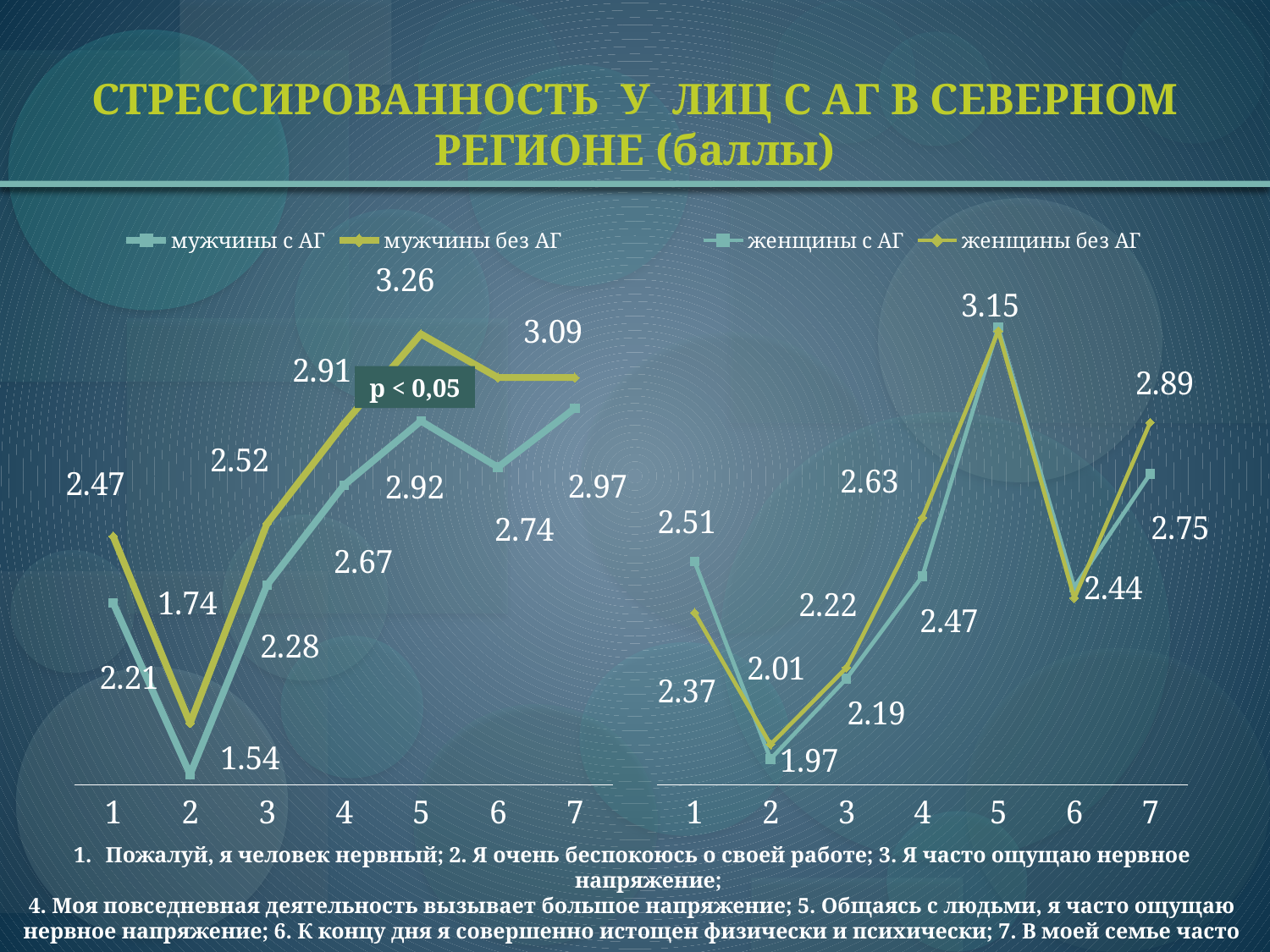
In the left chart (мужчины), what is the value for мужчины с АГ at item 7? 2.97 In the left chart (мужчины), at which item is мужчины с АГ lowest? 2 What type of chart is shown on the left side of the slide? line chart In the left chart (мужчины), what is the value for мужчины без АГ at item 5? 3.26 How many series does the legend of the right chart (женщины) list? 2 In the left chart (мужчины), what is the value for мужчины с АГ at item 2? 1.54 In the left chart (мужчины), at which item does мужчины без АГ reach its highest value? 5 In the left chart (мужчины), which series has the larger value at item 1: мужчины с АГ or мужчины без АГ? мужчины без АГ In the right chart (женщины), at which item is женщины с АГ lowest? 2 In the right chart (женщины), what is the difference between женщины без АГ and женщины с АГ at item 4? 0.16 In the left chart (мужчины), what is the difference between мужчины без АГ and мужчины с АГ at item 5? 0.34 In the right chart (женщины), what is the value for женщины без АГ at item 7? 2.89